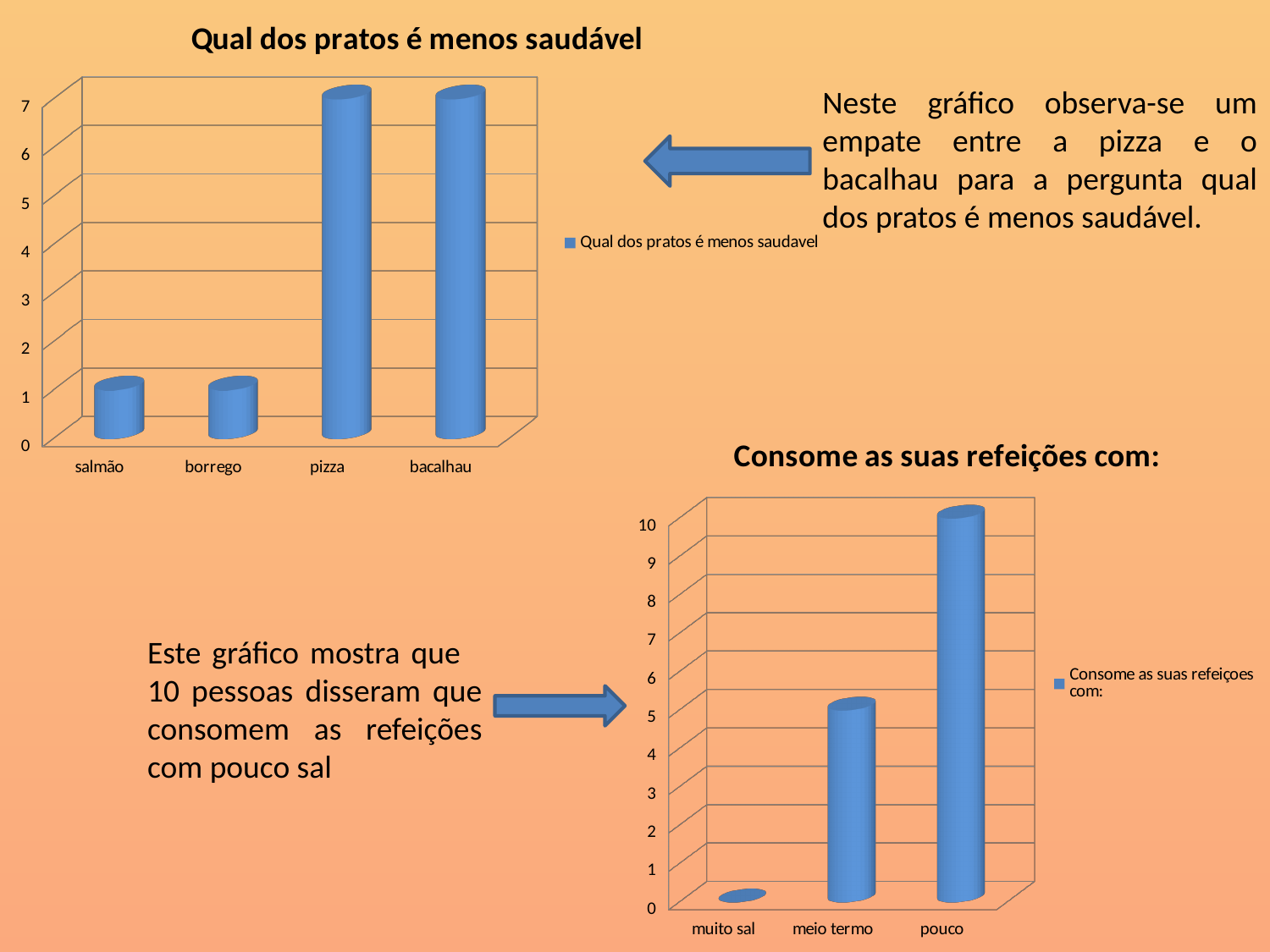
In the chart titled 'Qual dos pratos é menos saudável', how many categories are shown on the x axis? 4 In the chart titled 'Qual dos pratos é menos saudável', what kind of chart is shown? bar chart In the chart titled 'Qual dos pratos é menos saudável', which is larger, the value for pizza or the value for borrego? pizza In the chart titled 'Consome as suas refeições com:', is the value for meio termo greater or less than 3? greater In the chart titled 'Qual dos pratos é menos saudável', how many series does the legend list? 1 In the chart titled 'Consome as suas refeições com:', how many categories are shown on the x axis? 3 In the chart titled 'Qual dos pratos é menos saudável', which two categories tie for the highest value? pizza and bacalhau In the chart titled 'Qual dos pratos é menos saudável', is the value for salmão greater or less than 2? less In the chart titled 'Consome as suas refeições com:', which category has the highest value? pouco In the chart titled 'Qual dos pratos é menos saudável', is the value for pizza greater or less than 6? greater In the chart titled 'Consome as suas refeições com:', which category has the lowest value? muito sal In the chart titled 'Consome as suas refeições com:', what kind of chart is shown? bar chart